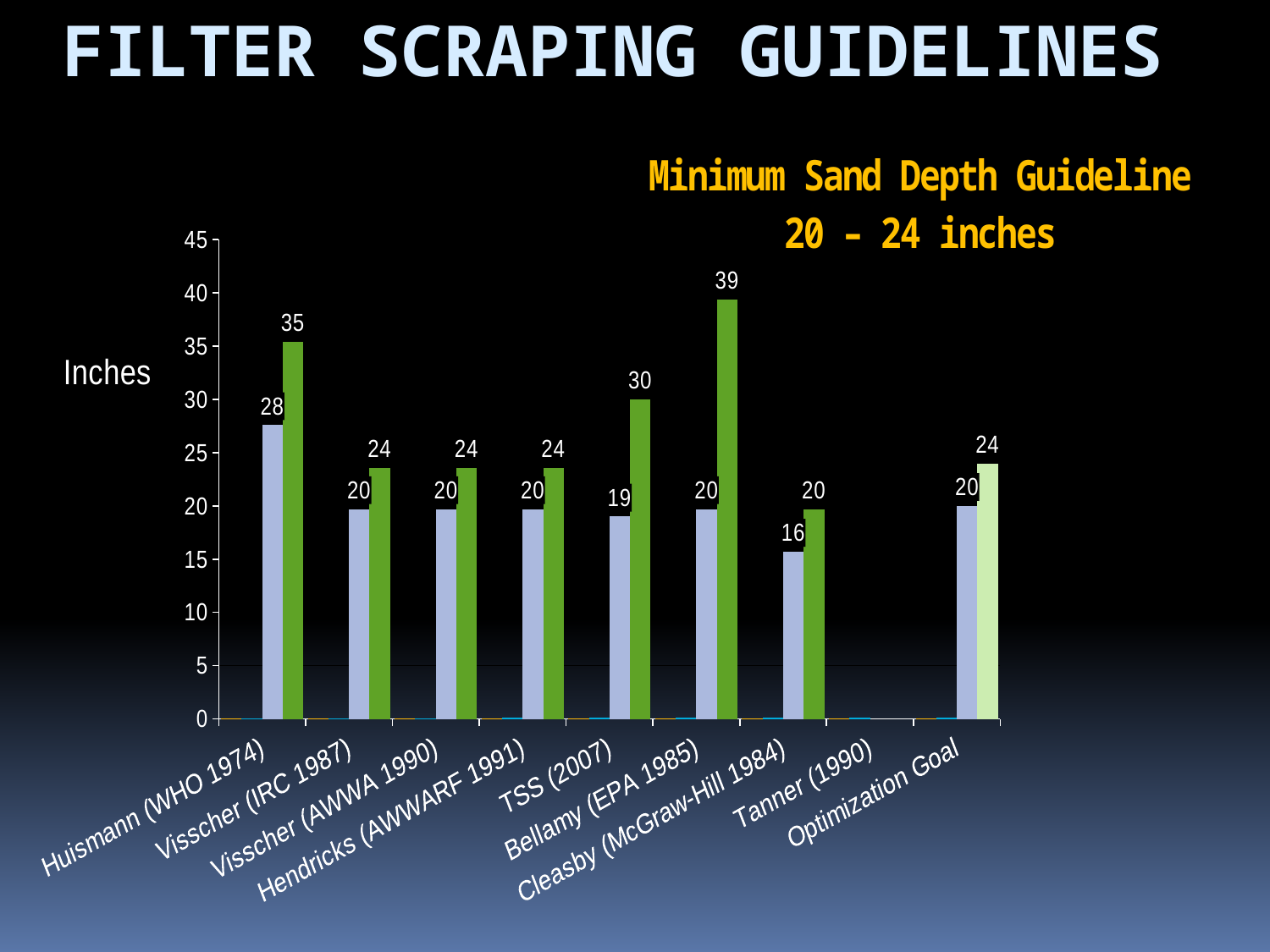
Which category has the lowest blue bar among those with bars shown? Cleasby (McGraw-Hill 1984) How many categories are labelled on the x axis? 9 Which category has the highest green bar? Bellamy (EPA 1985) What is the value of the green bar for Bellamy (EPA 1985)? 39 What unit is shown on the y axis label? Inches What is the value of the blue bar for Huismann (WHO 1974)? 28 What is the difference between the green bar and the blue bar for Huismann (WHO 1974)? 7 What kind of chart is shown on the slide? bar chart Which is larger, the green bar for Huismann (WHO 1974) or the green bar for TSS (2007)? Huismann (WHO 1974) What is the value of the green bar for TSS (2007)? 30 What is the value of the blue bar for Cleasby (McGraw-Hill 1984)? 16 What is the difference between the green bar for Bellamy (EPA 1985) and the green bar for TSS (2007)? 9